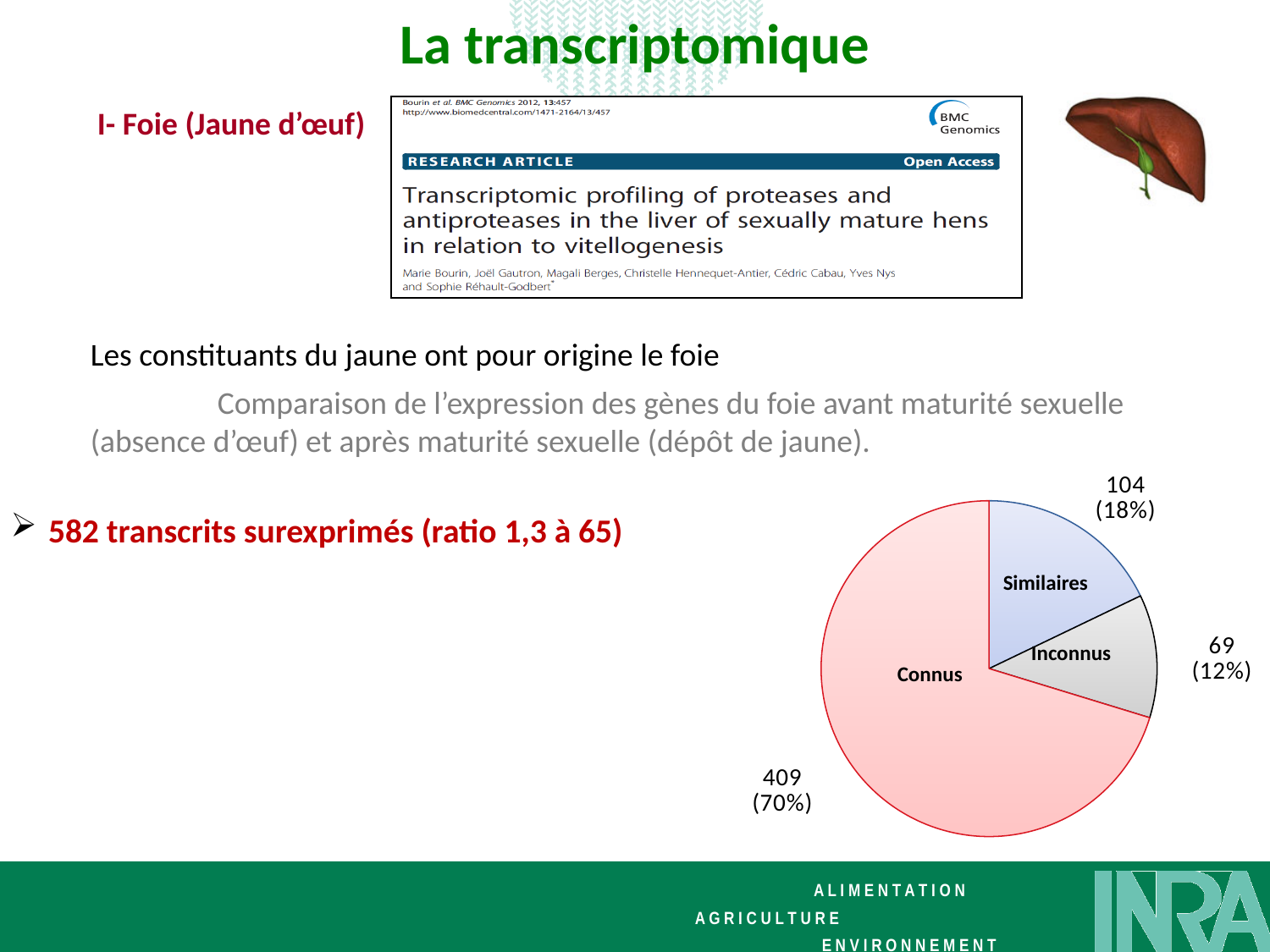
Which slice is the largest? Connus Which slice is the smallest? Inconnus What is the value for the Connus slice? 409 What percentage share does the Connus slice represent? 70% What kind of chart is shown on the slide? pie chart How many slices does the pie chart have? 3 Which is larger, Similaires or Inconnus? Similaires What percentage share does the Inconnus slice represent? 12% What is the value for the Similaires slice? 104 What is the total of the three slices in the pie chart? 582 What is the value for the Inconnus slice? 69 What is the difference between the Similaires and Inconnus values? 35